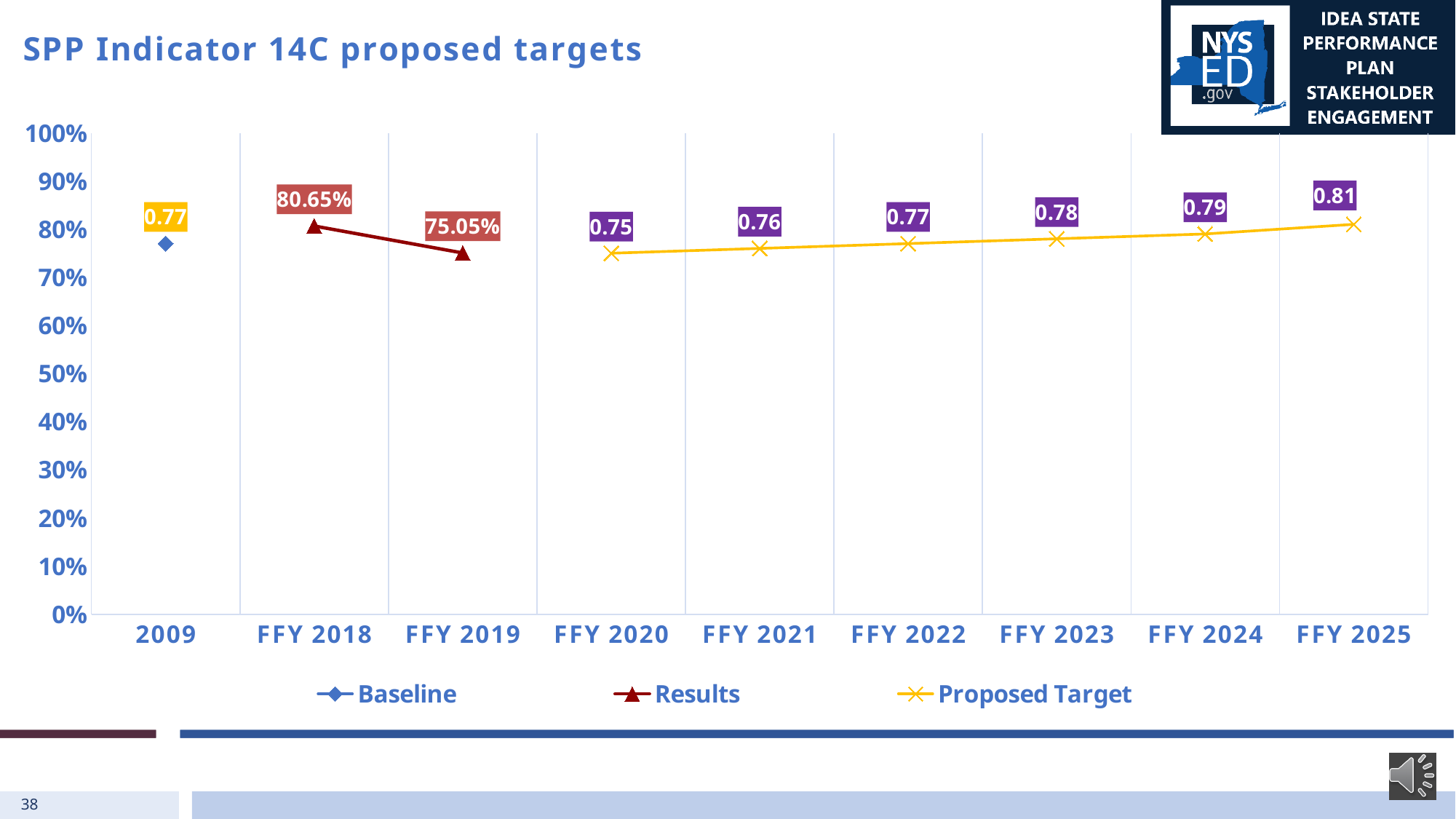
Which year has the lowest Proposed Target? FFY 2020 What is the Proposed Target for FFY 2025? 0.81 What is the difference between the Results values for FFY 2018 and FFY 2019? 5.6% What is the Proposed Target for FFY 2022? 0.77 Which year has the highest Proposed Target? FFY 2025 Do the Proposed Target values rise or fall from FFY 2020 to FFY 2025? rise What is the Baseline value for 2009? 0.77 What is the title of the chart? SPP Indicator 14C proposed targets What is the Results value for FFY 2019? 75.05% How many series does the legend list? 3 Which is larger, the Results value for FFY 2018 or for FFY 2019? FFY 2018 What is the Results value for FFY 2018? 80.65%